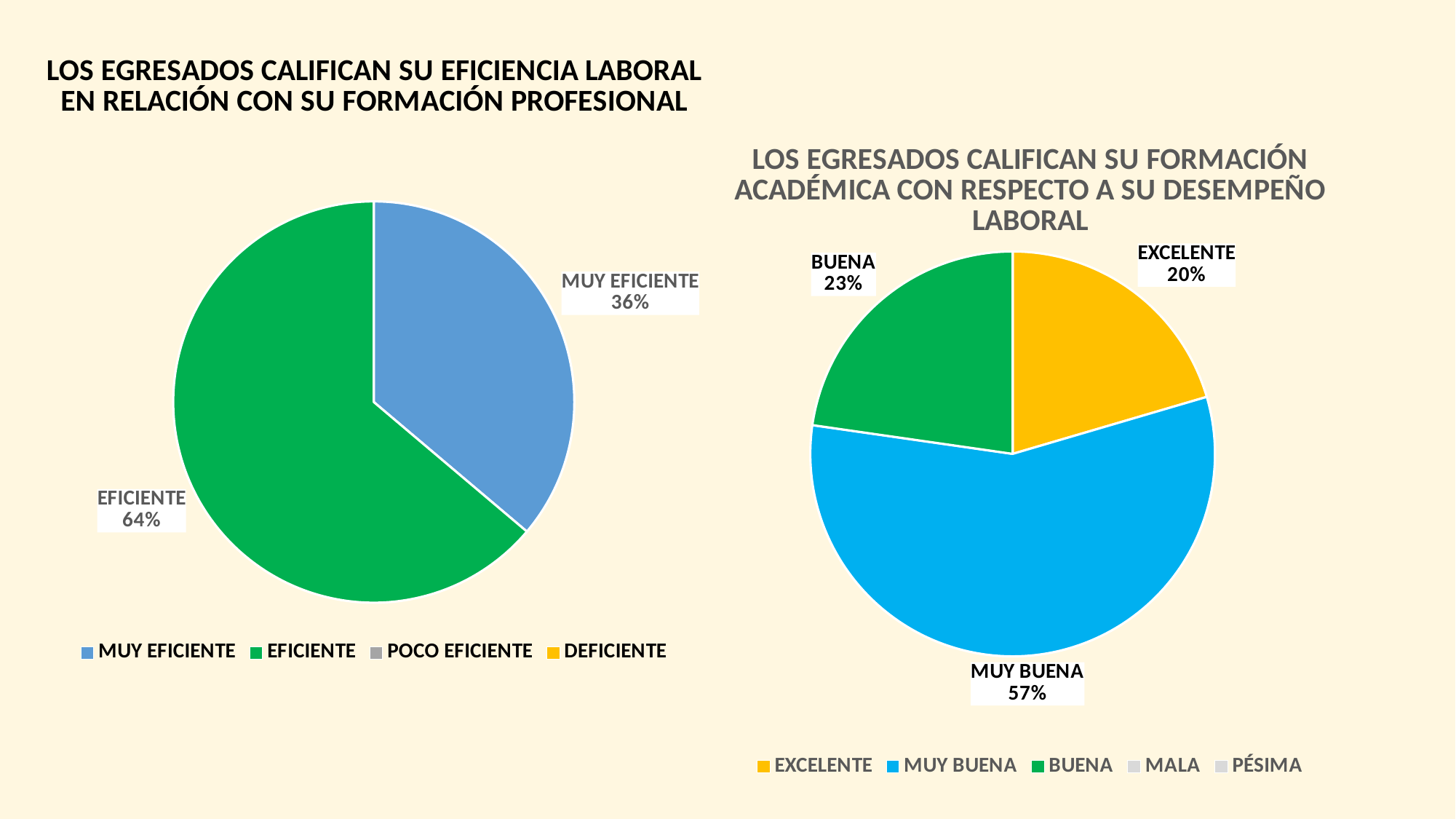
In the right pie chart (formación académica), what percentage is labelled for MUY BUENA? 57% In the left pie chart (eficiencia laboral), what percentage is labelled for MUY EFICIENTE? 36% In the right pie chart (formación académica), how many entries does the legend list? 5 In the right pie chart (formación académica), what percentage is labelled for EXCELENTE? 20% In the left pie chart (eficiencia laboral), how many entries does the legend list? 4 In the right pie chart (formación académica), which labelled category has the smallest slice? EXCELENTE In the right pie chart (formación académica), what percentage is labelled for BUENA? 23% In the left pie chart (eficiencia laboral), what is the difference in percentage points between EFICIENTE and MUY EFICIENTE? 28 In the right pie chart (formación académica), which is larger, BUENA or EXCELENTE? BUENA What type of chart is used on the right side of the slide? Pie chart In the left pie chart (eficiencia laboral), which category has the largest slice? EFICIENTE In the left pie chart (eficiencia laboral), what percentage is labelled for EFICIENTE? 64%